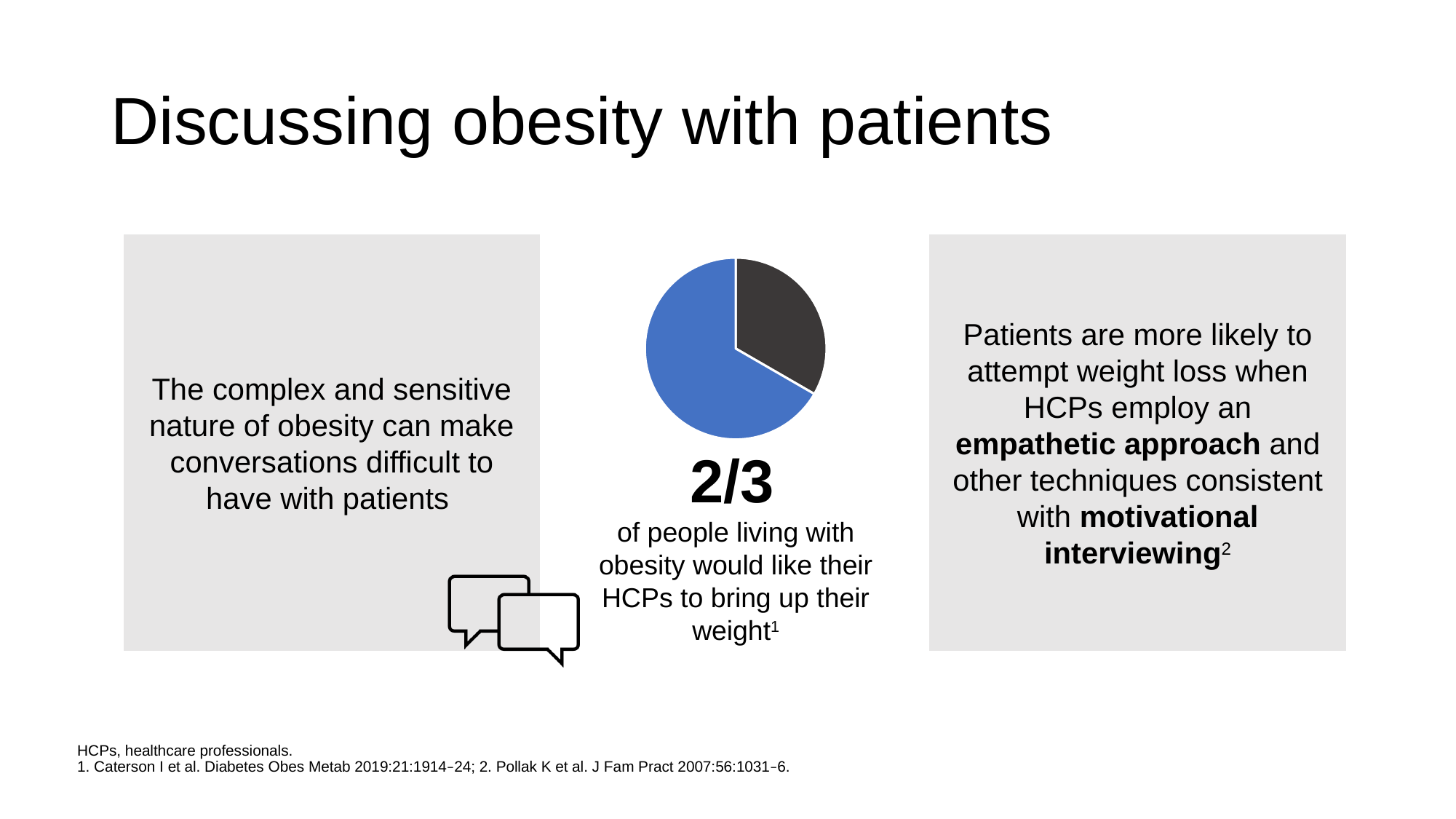
According to the text under the pie chart, what does the 2/3 figure represent? People living with obesity who would like their HCPs to bring up their weight Is the blue slice of the pie chart greater or less than half of the pie? greater What two colours are used for the slices of the pie chart? Blue and dark grey How many slices does the pie chart have? 2 Which slice of the pie chart is larger, the blue one or the dark grey one? The blue one What kind of chart is shown in the middle of the slide? Pie chart Which slice of the pie chart is the smallest? The dark grey slice What fraction is printed in bold beneath the pie chart? 2/3 Is the dark grey slice of the pie chart greater or less than half of the pie? less What share of the pie does the blue slice represent, according to the figure printed below the chart? 2/3